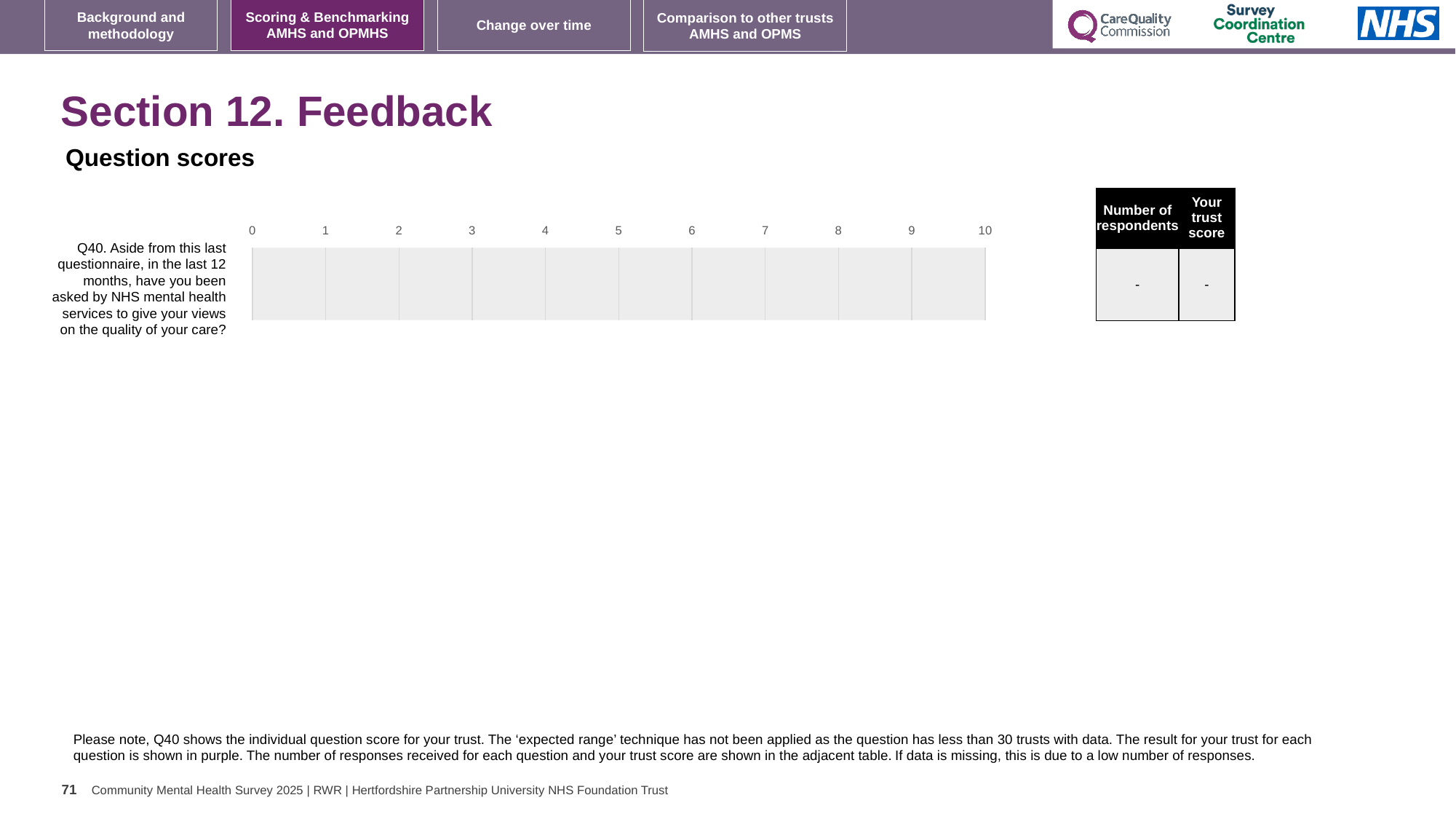
What is shown in the 'Your trust score' column of the table for Q40? - What is the lowest value shown on the chart's horizontal axis? 0 Which question is labelled on the chart? Q40 What kind of chart is shown on the slide? bar chart What is the highest value shown on the chart's horizontal axis? 10 What is shown in the 'Number of respondents' column of the table for Q40? - How many question categories are listed on the chart's vertical axis? 1